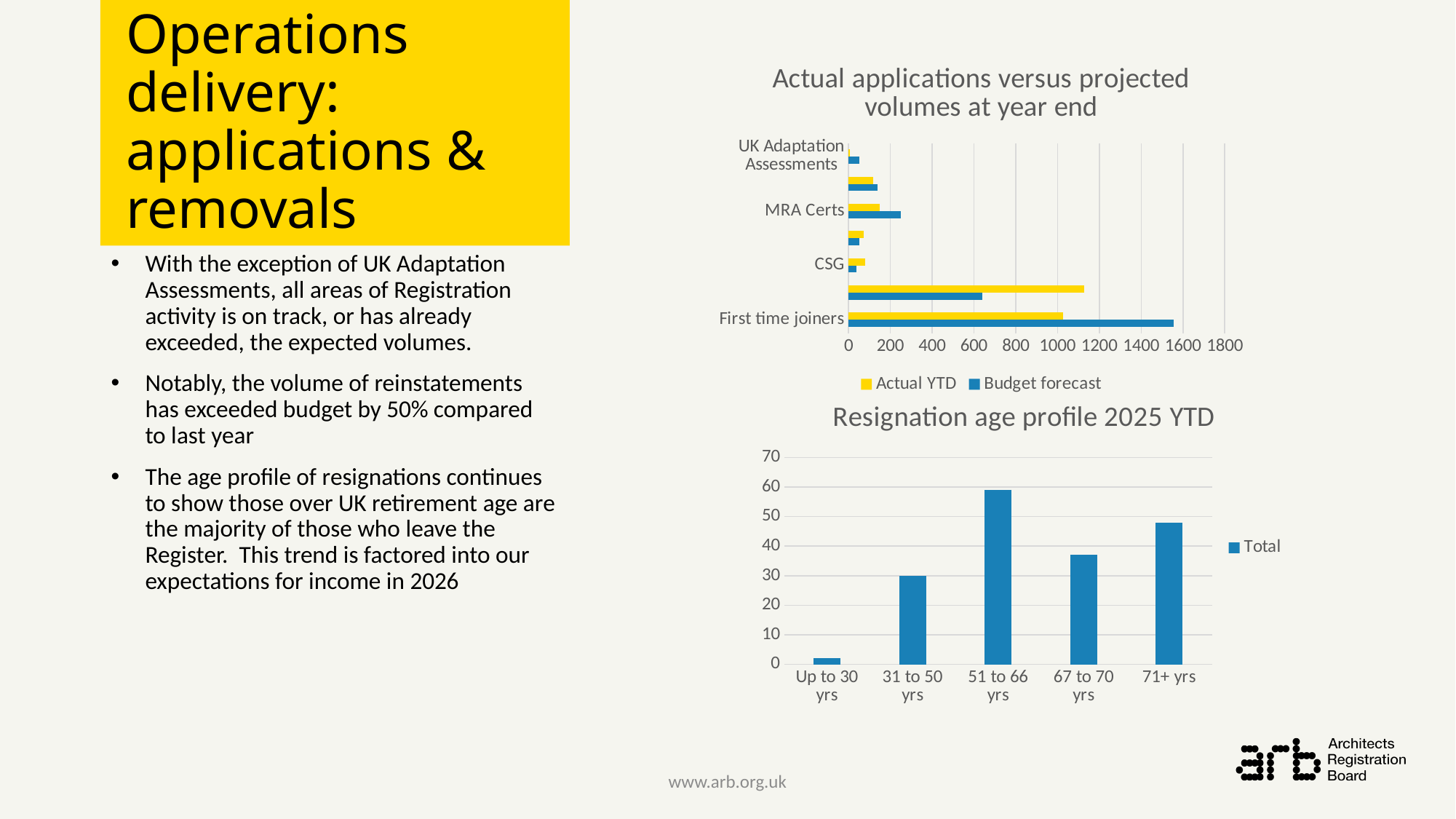
What kind of chart is the 'Resignation age profile 2025 YTD' chart? bar chart In the 'Actual applications versus projected volumes at year end' chart, is the Budget forecast value for First time joiners greater or less than 1400? greater What kind of chart is the 'Actual applications versus projected volumes at year end' chart? bar chart In the 'Resignation age profile 2025 YTD' chart, which is larger: 71+ yrs or 67 to 70 yrs? 71+ yrs In the 'Resignation age profile 2025 YTD' chart, is the value for 51 to 66 yrs greater or less than 50? greater In the 'Actual applications versus projected volumes at year end' chart, is the Budget forecast value for CSG greater or less than 200? less In the 'Actual applications versus projected volumes at year end' chart, which is larger for First time joiners: Actual YTD or Budget forecast? Budget forecast How many age categories are shown on the x axis of the 'Resignation age profile 2025 YTD' chart? 5 What are the two series named in the legend of the 'Actual applications versus projected volumes at year end' chart? Actual YTD and Budget forecast How many series does the legend of the 'Actual applications versus projected volumes at year end' chart list? 2 In the 'Resignation age profile 2025 YTD' chart, which age category has the highest value? 51 to 66 yrs In the 'Resignation age profile 2025 YTD' chart, which age category has the lowest value? Up to 30 yrs